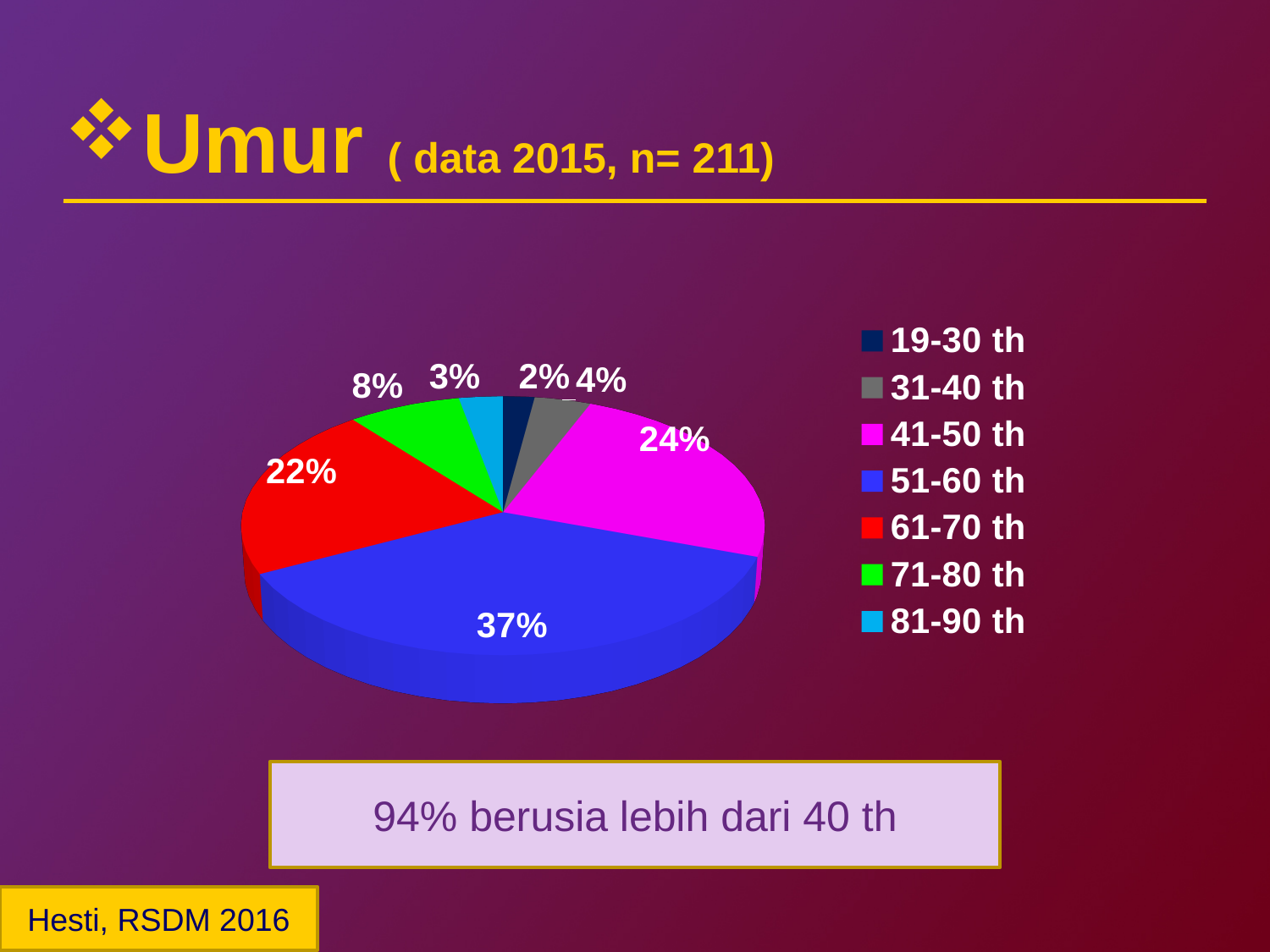
What percentage of the pie is the 51-60 th slice? 37% What percentage is shown for the 61-70 th age group? 22% What is the difference in percentage points between the 51-60 th and 41-50 th slices? 13 How many age groups are shown in the pie chart? 7 What percentage is shown for the 41-50 th age group? 24% What kind of chart is shown on the slide? pie chart What is the combined share of the 19-30 th and 31-40 th slices? 6% What colour is the 61-70 th slice in the pie chart? red What percentage is shown for the 19-30 th age group? 2% Which age group has the smallest share of the pie? 19-30 th Which slice is larger, 71-80 th or 81-90 th? 71-80 th Which age group has the largest share of the pie? 51-60 th